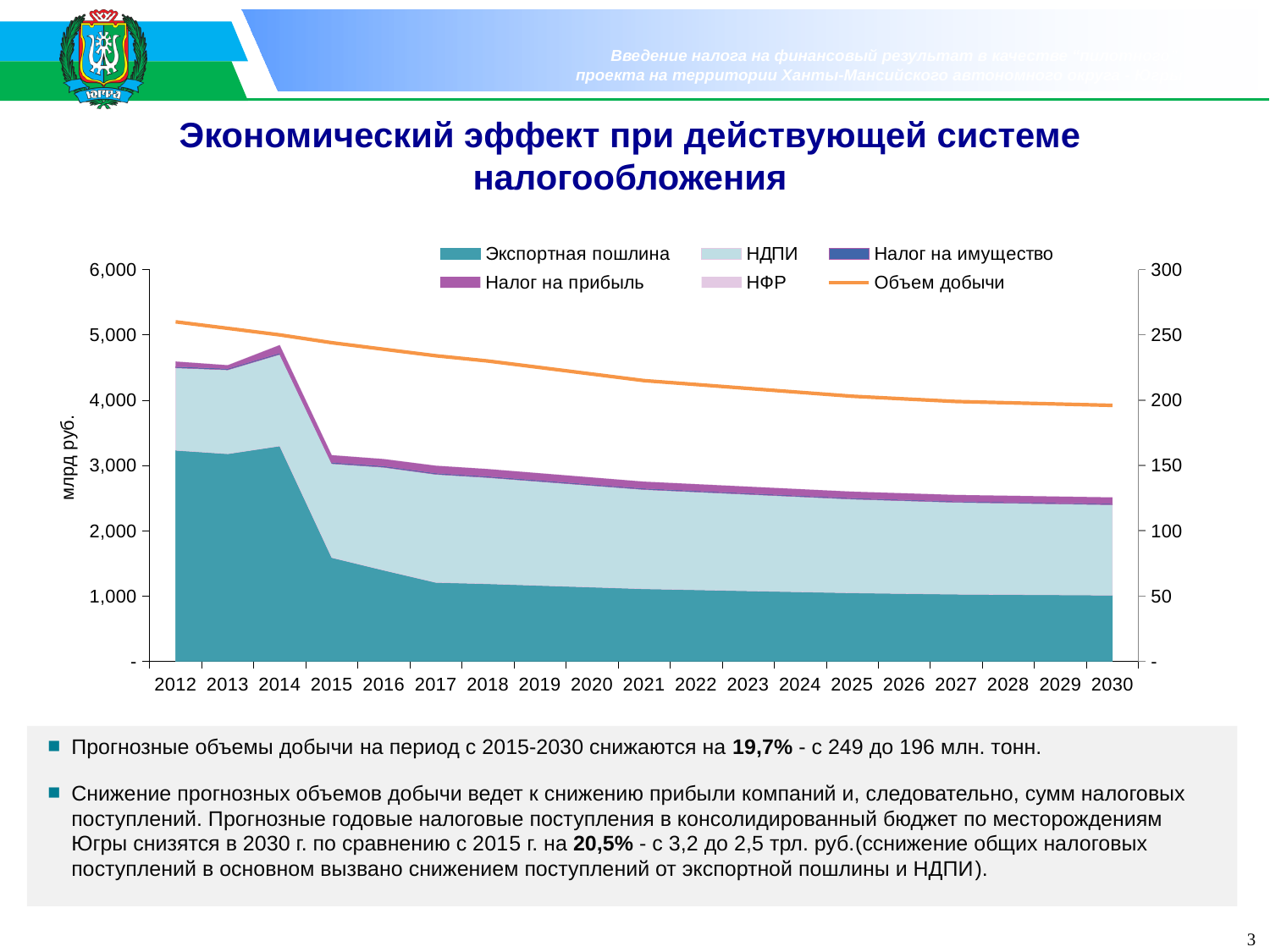
Which is larger, the Экспортная пошлина value in 2014 or in 2015? 2014 What kind of chart is shown on the slide? Stacked area chart with a line Is the value of Экспортная пошлина in 2014 greater or less than 3,000? greater Is the value of Экспортная пошлина in 2030 greater or less than 1,500? less What is the label on the left vertical axis of the chart? млрд руб. Does the Объем добычи line rise or fall from 2012 to 2030? Falls How many years are shown along the x axis of the chart? 19 Which year has the highest value of Объем добычи? 2012 How many series does the chart legend list? 6 Which year has the lowest value of Объем добычи? 2030 Is the value of Объем добычи in 2012 greater or less than 250 on the right axis? greater